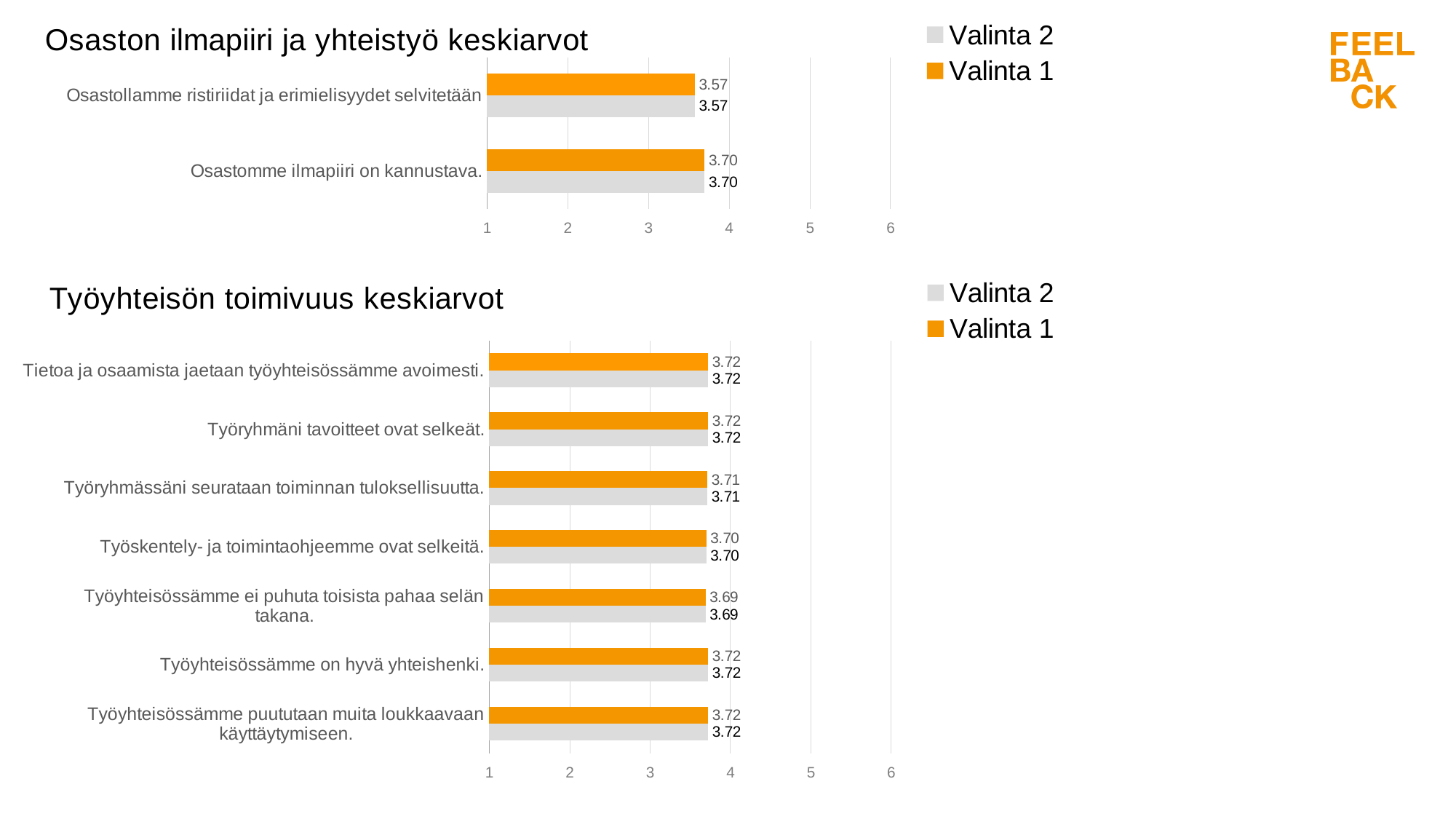
How many series does the legend of the chart titled 'Työyhteisön toimivuus keskiarvot' list? 2 On the chart titled 'Työyhteisön toimivuus keskiarvot', which category has the lowest value? Työyhteisössämme ei puhuta toisista pahaa selän takana. On the chart titled 'Osaston ilmapiiri ja yhteistyö keskiarvot', what is the Valinta 2 value for 'Osastomme ilmapiiri on kannustava.'? 3.70 On the chart titled 'Osaston ilmapiiri ja yhteistyö keskiarvot', which category has the higher value? Osastomme ilmapiiri on kannustava. What kind of chart is the chart titled 'Työyhteisön toimivuus keskiarvot'? Bar chart How many categories are shown on the chart titled 'Osaston ilmapiiri ja yhteistyö keskiarvot'? 2 On the chart titled 'Osaston ilmapiiri ja yhteistyö keskiarvot', what is the Valinta 1 value for 'Osastollamme ristiriidat ja erimielisyydet selvitetään'? 3.57 On the chart titled 'Osaston ilmapiiri ja yhteistyö keskiarvot', what is the difference between the Valinta 1 values for 'Osastomme ilmapiiri on kannustava.' and 'Osastollamme ristiriidat ja erimielisyydet selvitetään'? 0.13 How many categories are shown on the chart titled 'Työyhteisön toimivuus keskiarvot'? 7 On the chart titled 'Työyhteisön toimivuus keskiarvot', what is the Valinta 1 value for 'Työryhmässäni seurataan toiminnan tuloksellisuutta.'? 3.71 On the chart titled 'Työyhteisön toimivuus keskiarvot', what is the Valinta 2 value for 'Työskentely- ja toimintaohjeemme ovat selkeitä.'? 3.70 On the chart titled 'Työyhteisön toimivuus keskiarvot', is the value for 'Työyhteisössämme on hyvä yhteishenki.' greater or less than 4? less